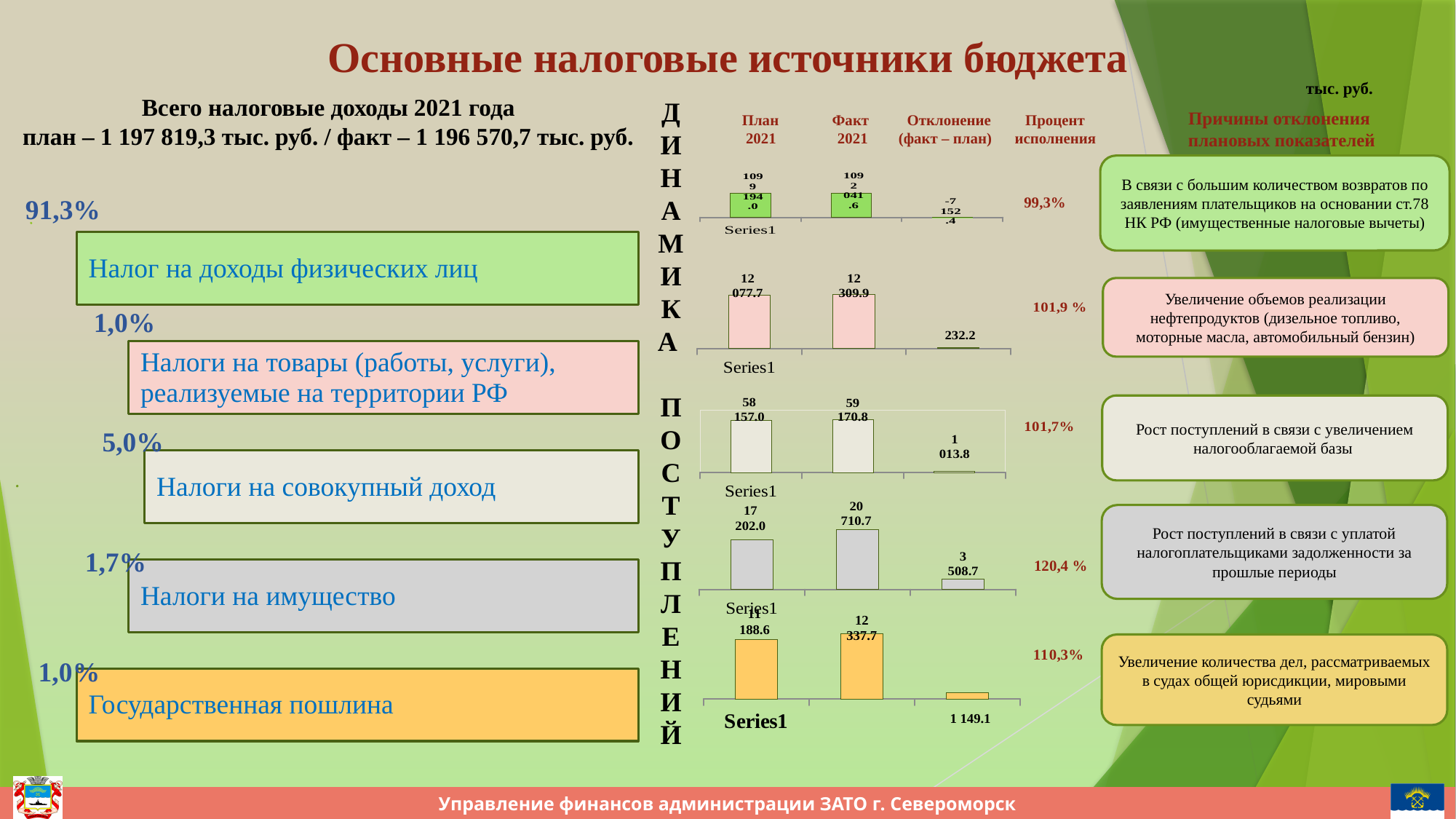
In the second chart from the top (pink bars), what is the value of the План 2021 bar? 12 077.7 How many bars does the third chart from the top (beige bars) contain? 3 In the fourth chart from the top (grey bars), what is the difference between the Факт 2021 and План 2021 values? 3 508.7 In the third chart from the top (beige bars), what is the value of the Отклонение bar? 1 013.8 In the bottom chart (yellow bars), what is the value of the Отклонение bar? 1 149.1 What type of chart is the bottom chart (yellow bars)? Bar chart In the fourth chart from the top (grey bars), which bar is the tallest? Факт 2021 In the third chart from the top (beige bars), which bar is the lowest? Отклонение In the bottom chart (yellow bars), what is the value of the План 2021 bar? 11 188.6 In the bottom chart (yellow bars), which is larger, the План 2021 bar or the Факт 2021 bar? Факт 2021 In the fourth chart from the top (grey bars), what is the value of the Факт 2021 bar? 20 710.7 In the second chart from the top (pink bars), what is the value of the Факт 2021 bar? 12 309.9